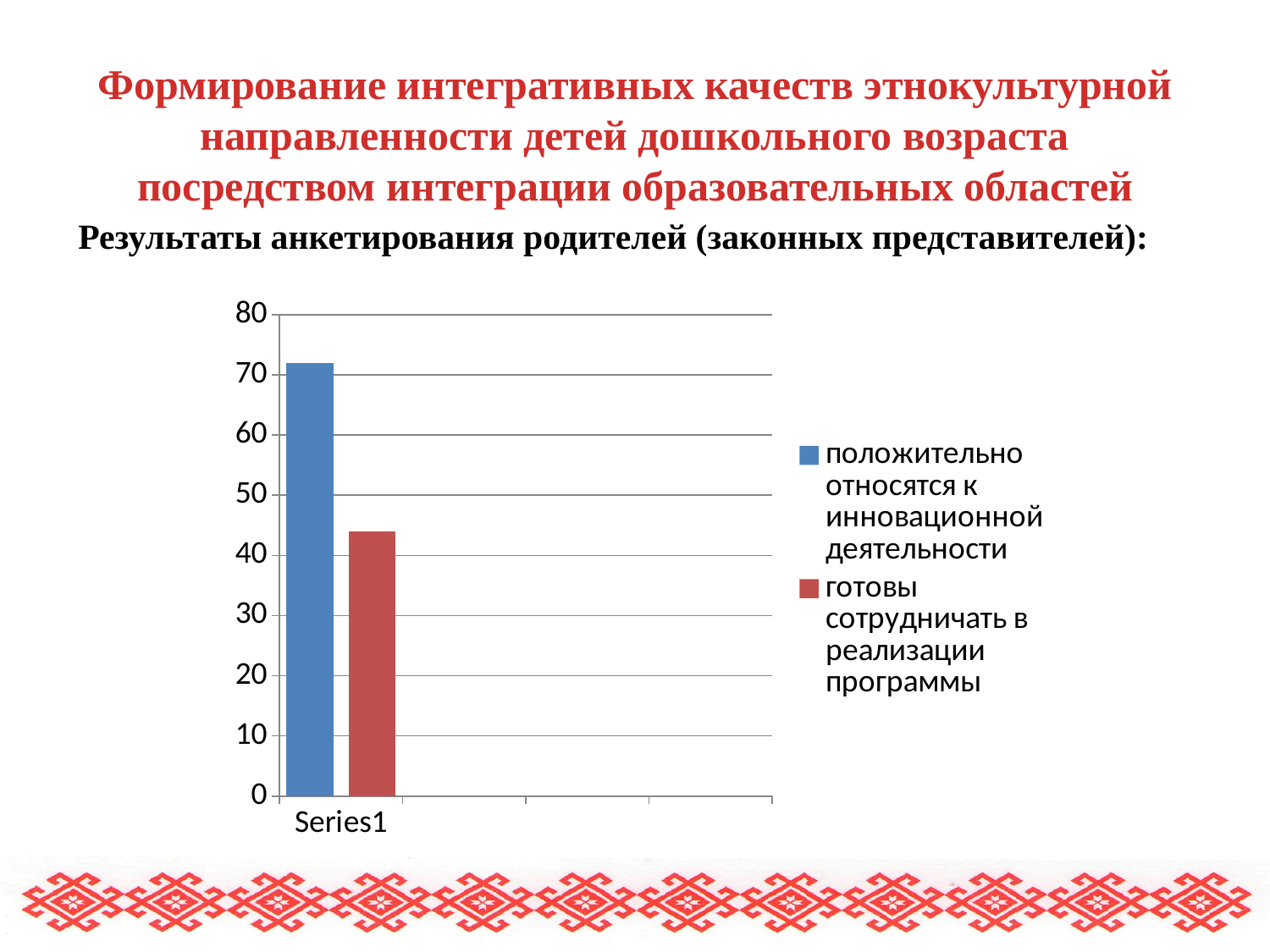
Which series has the highest value in the chart? положительно относятся к инновационной деятельности Is the value for "готовы сотрудничать в реализации программы" greater or less than 50? less What colour is the bar for "готовы сотрудничать в реализации программы"? red How many categories are shown on the x axis of the chart? 1 How many series does the legend list? 2 Is the value for "положительно относятся к инновационной деятельности" greater or less than 80? less Is the value for "готовы сотрудничать в реализации программы" greater or less than 40? greater Which series has the taller bar: "положительно относятся к инновационной деятельности" or "готовы сотрудничать в реализации программы"? положительно относятся к инновационной деятельности What is the category label shown on the x axis of the chart? Series1 Which series has the lowest value in the chart? готовы сотрудничать в реализации программы What kind of chart is shown on the slide? bar chart